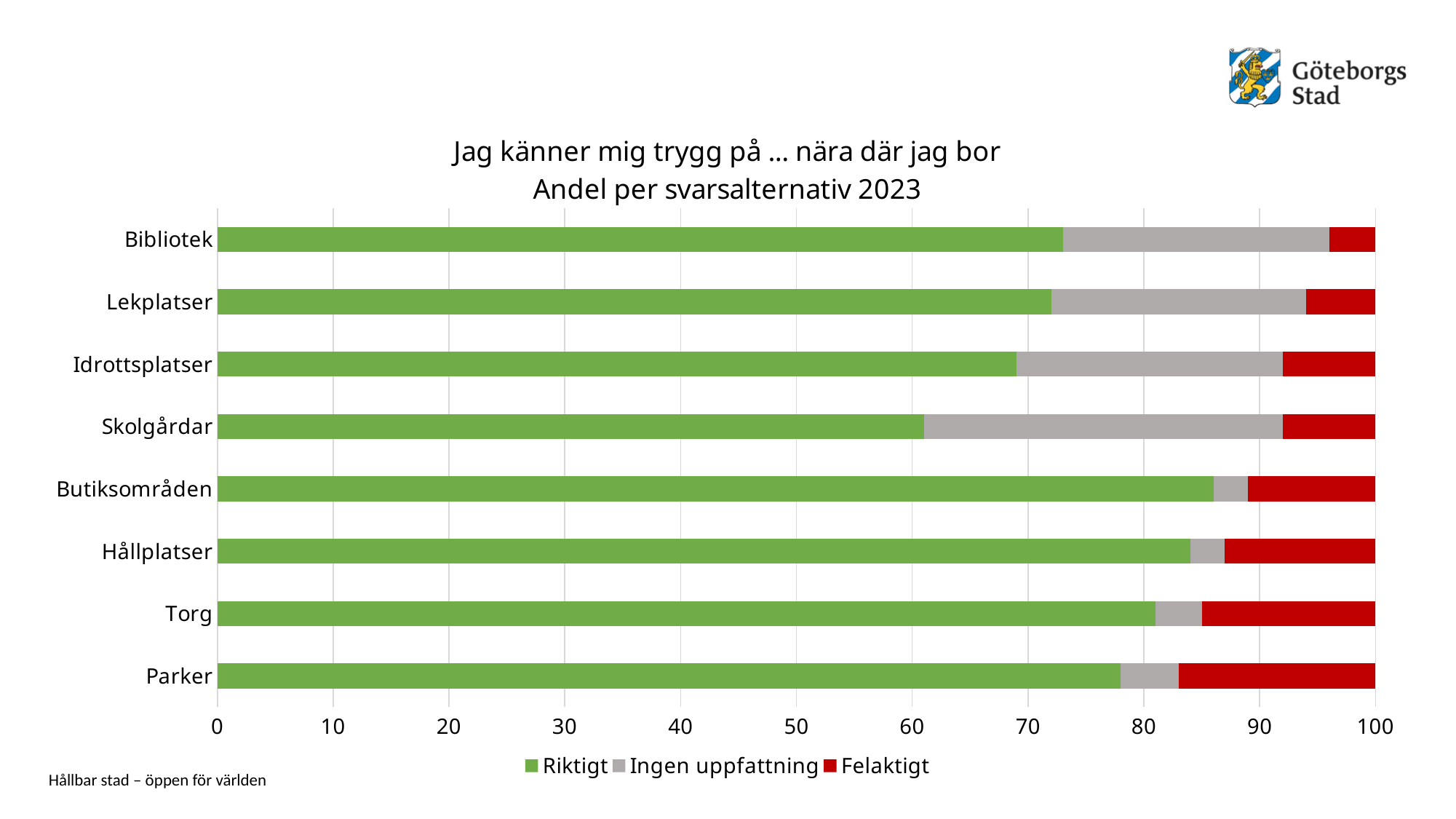
Which has a larger Riktigt value, Skolgårdar or Butiksområden? Butiksområden Which has a larger Ingen uppfattning segment, Skolgårdar or Butiksområden? Skolgårdar Is the Riktigt value for Hållplatser greater or less than 80? greater How many categories (places) are listed on the vertical axis of the chart? 8 How many series does the legend list? 3 Which category has the lowest value for Riktigt? Skolgårdar Is the Riktigt value for Bibliotek greater or less than 70? greater Is the Riktigt value for Skolgårdar greater or less than 70? less Which colour represents Felaktigt in the chart? Red Which category has the largest Ingen uppfattning segment? Skolgårdar What kind of chart is shown on the slide? Stacked bar chart